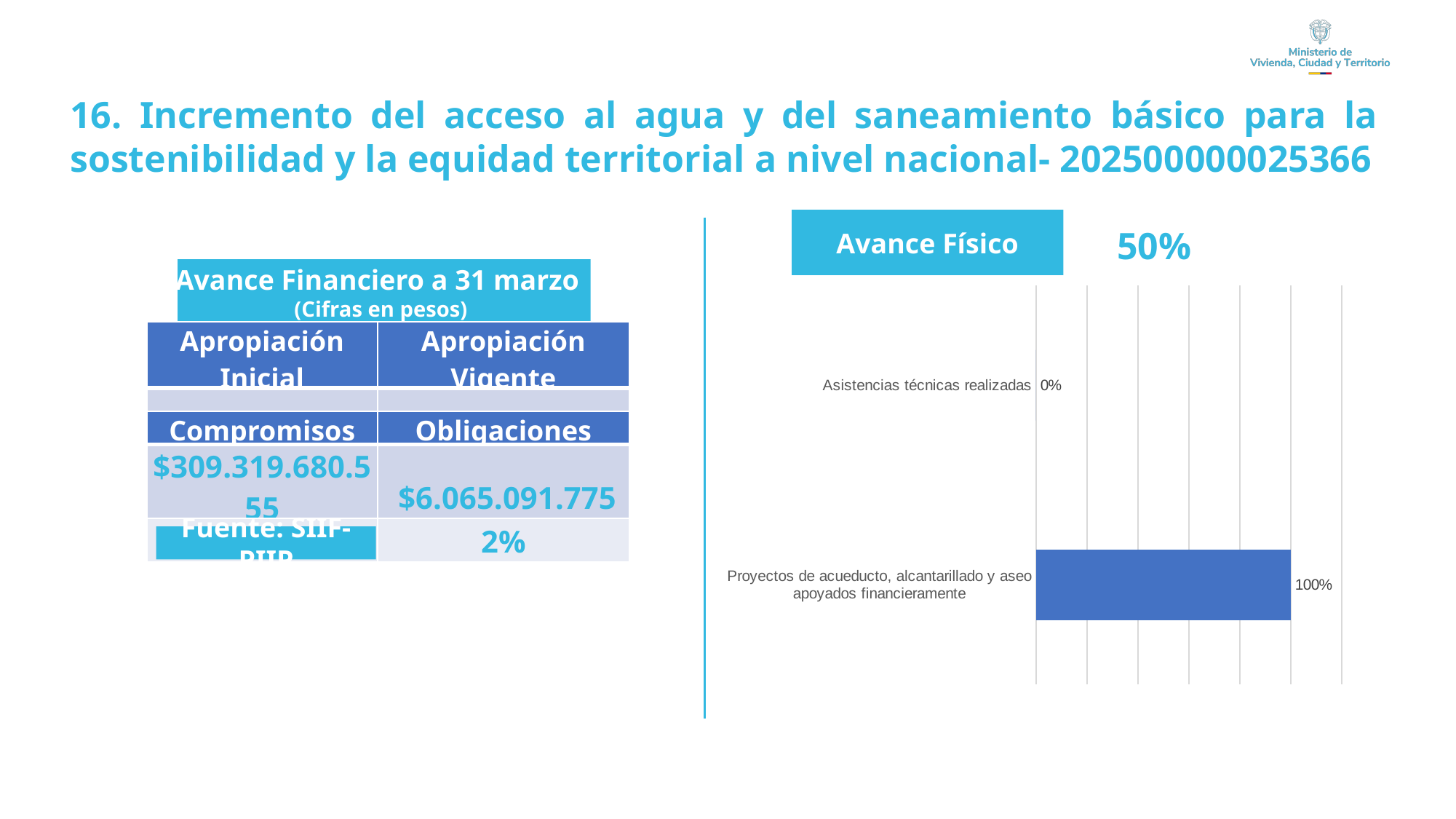
In the "Avance Físico" chart, what is the difference between the value for "Proyectos de acueducto, alcantarillado y aseo apoyados financieramente" and the value for "Asistencias técnicas realizadas"? 100% What is the heading shown above the bar chart on the right side of the slide? Avance Físico In the "Avance Físico" chart, what is the value for "Proyectos de acueducto, alcantarillado y aseo apoyados financieramente"? 100% What overall percentage is displayed next to the "Avance Físico" heading? 50% Which category in the "Avance Físico" chart has the highest value? Proyectos de acueducto, alcantarillado y aseo apoyados financieramente In the "Avance Físico" chart, which is larger: the value for "Asistencias técnicas realizadas" or the value for "Proyectos de acueducto, alcantarillado y aseo apoyados financieramente"? Proyectos de acueducto, alcantarillado y aseo apoyados financieramente How many categories are plotted in the "Avance Físico" chart? 2 Which category in the "Avance Físico" chart has the lowest value? Asistencias técnicas realizadas In the "Avance Físico" chart, what is the value for "Asistencias técnicas realizadas"? 0% What kind of chart is shown under the "Avance Físico" heading? bar chart